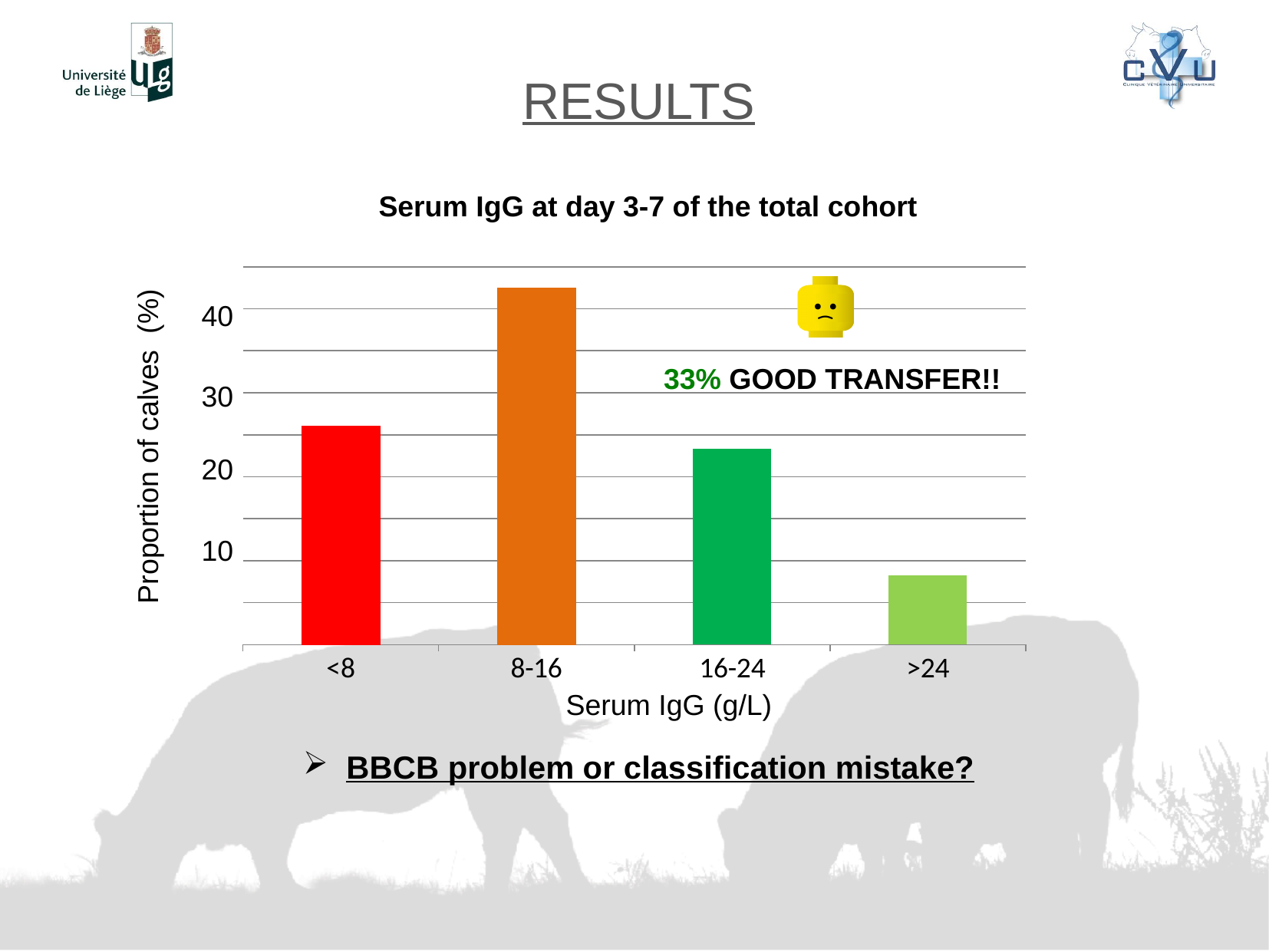
What kind of chart is shown on the slide? bar chart Is the proportion of calves for the 16-24 category greater or less than 30? less Which serum IgG category has the lowest proportion of calves? >24 Is the proportion of calves for the 8-16 category greater or less than 40? greater Which serum IgG category has the highest proportion of calves? 8-16 Which has a larger proportion of calves, the 8-16 category or the 16-24 category? 8-16 How many serum IgG categories are plotted on the x axis? 4 Is the proportion of calves for the <8 category greater or less than 20? greater What is the title of the chart? Serum IgG at day 3-7 of the total cohort Which has a larger proportion of calves, the <8 category or the >24 category? <8 What is the label of the x axis? Serum IgG (g/L)